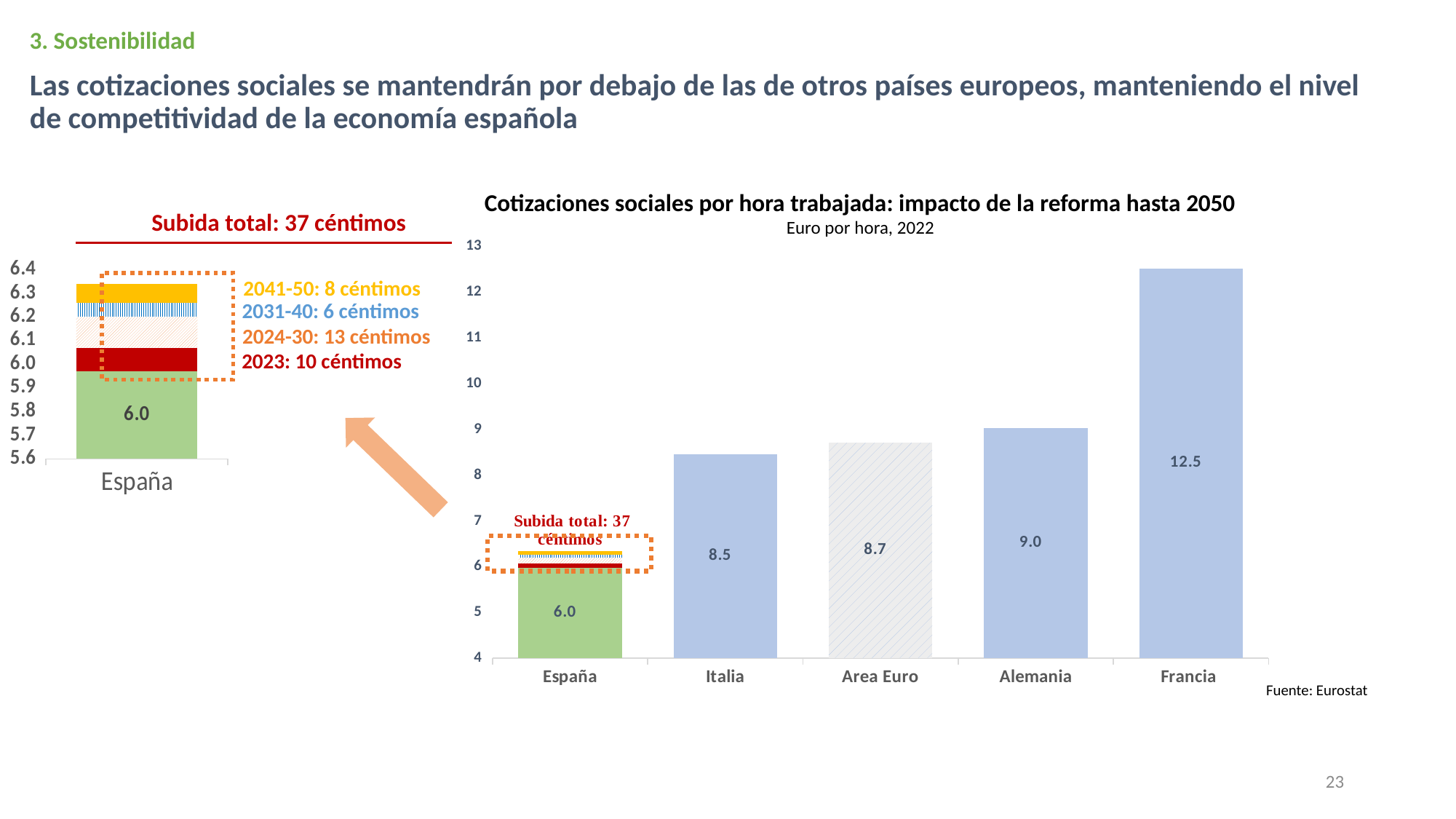
In the stacked bar chart on the left of the slide, what is the total increase ('Subida total') shown above the bar? 37 céntimos In the chart titled 'Cotizaciones sociales por hora trabajada: impacto de la reforma hasta 2050', what is the value for Francia? 12.5 How many categories are shown on the x axis of the chart titled 'Cotizaciones sociales por hora trabajada: impacto de la reforma hasta 2050'? 5 In the chart titled 'Cotizaciones sociales por hora trabajada: impacto de la reforma hasta 2050', which category has the lowest value? España In the chart titled 'Cotizaciones sociales por hora trabajada: impacto de la reforma hasta 2050', what is the value for Area Euro? 8.7 In the chart titled 'Cotizaciones sociales por hora trabajada: impacto de la reforma hasta 2050', what is the difference between the values for Francia and Alemania? 3.5 In the chart titled 'Cotizaciones sociales por hora trabajada: impacto de la reforma hasta 2050', which country has the highest value? Francia In the chart titled 'Cotizaciones sociales por hora trabajada: impacto de la reforma hasta 2050', which is larger, the value for Alemania or the value for Italia? Alemania In the chart titled 'Cotizaciones sociales por hora trabajada: impacto de la reforma hasta 2050', is the value for Francia greater or less than 12? greater What kind of chart is the one titled 'Cotizaciones sociales por hora trabajada: impacto de la reforma hasta 2050'? Bar chart In the stacked bar chart on the left of the slide, what is the value of the green base segment for España? 6.0 In the chart titled 'Cotizaciones sociales por hora trabajada: impacto de la reforma hasta 2050', what is the value for Italia? 8.5